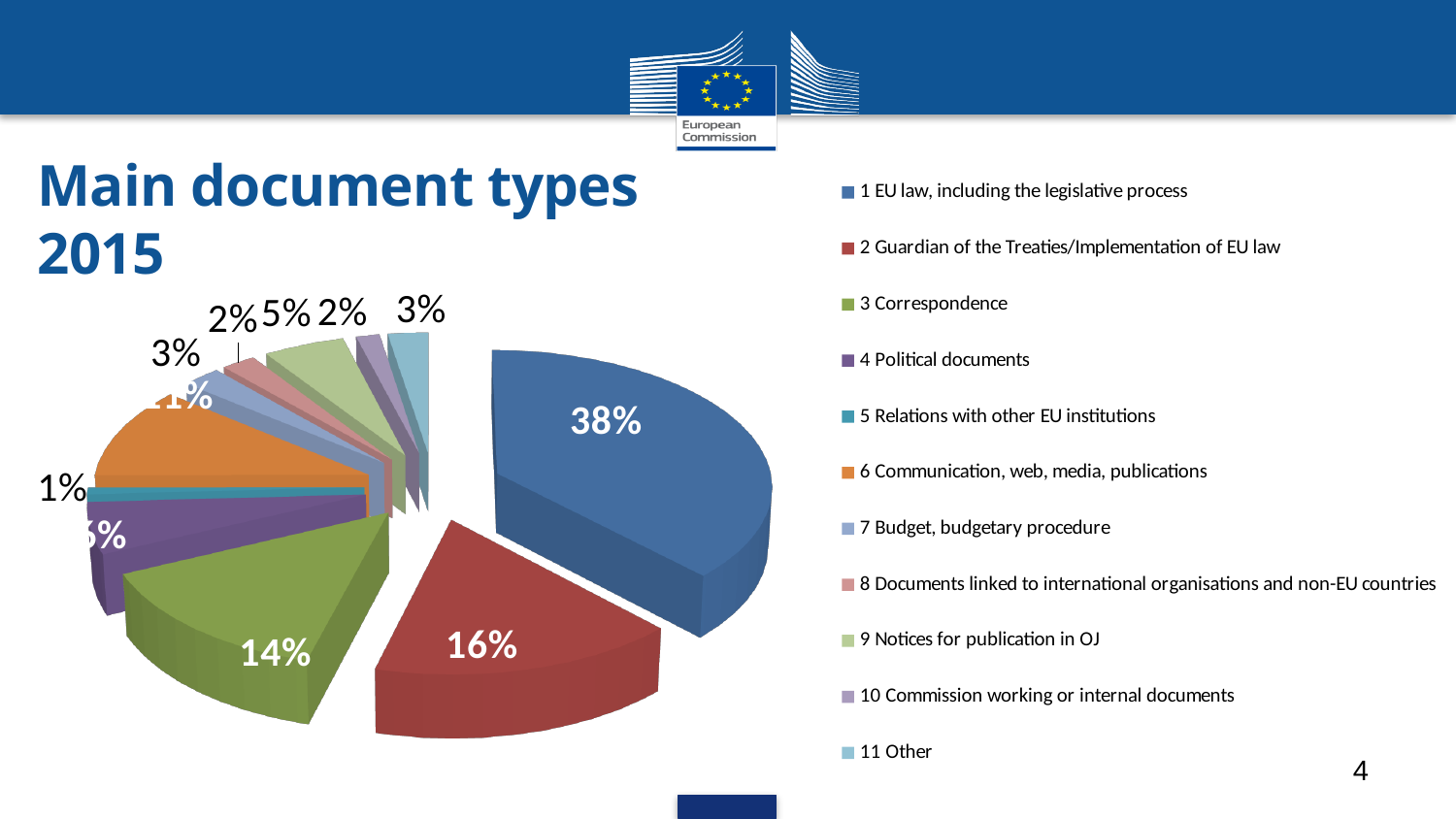
How many percentage points larger is the share for '1 EU law, including the legislative process' than for '2 Guardian of the Treaties/Implementation of EU law'? 22 percentage points What kind of chart is shown on the slide? Pie chart What percentage is shown for '3 Correspondence'? 14% What percentage is shown for '5 Relations with other EU institutions'? 1% Which document type has the smallest share of the pie? 5 Relations with other EU institutions Which document type has the largest share of the pie? 1 EU law, including the legislative process How many document types are listed in the legend? 11 What percentage is shown for '11 Other'? 3% What share of the pie does '1 EU law, including the legislative process' represent? 38% What percentage is shown for '9 Notices for publication in OJ'? 5% Which has the larger share: '3 Correspondence' or '2 Guardian of the Treaties/Implementation of EU law'? 2 Guardian of the Treaties/Implementation of EU law What percentage is shown for '2 Guardian of the Treaties/Implementation of EU law'? 16%